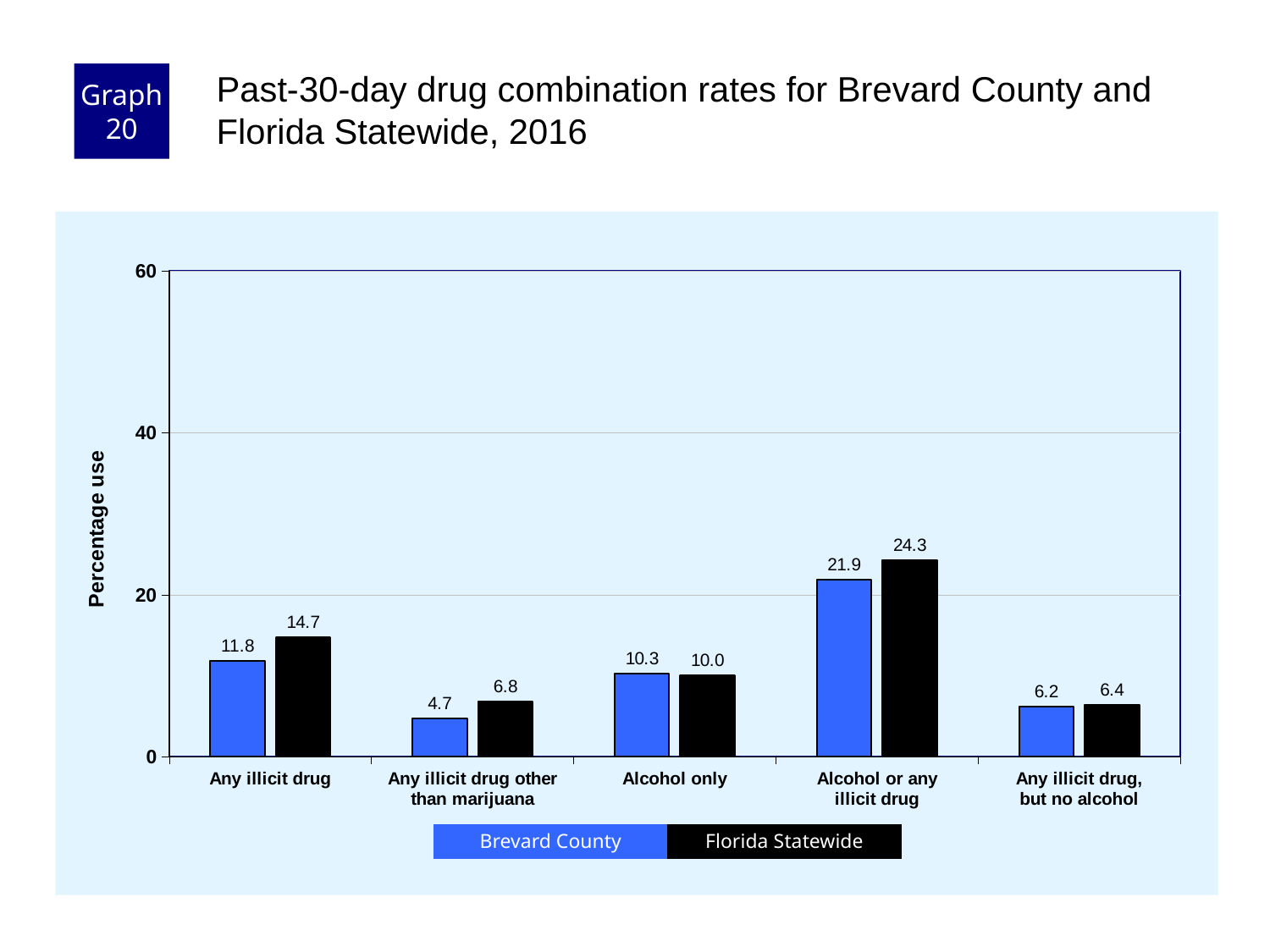
Is the Florida Statewide value for Alcohol or any illicit drug greater or less than 20? greater How many series does the legend list? 2 What is the Brevard County value for Any illicit drug? 11.8 Which is larger for Alcohol only: Brevard County or Florida Statewide? Brevard County What is the Florida Statewide value for Alcohol or any illicit drug? 24.3 Which category has the lowest Florida Statewide value? Any illicit drug, but no alcohol What is the Florida Statewide value for Any illicit drug other than marijuana? 6.8 What is the label of the y axis? Percentage use What kind of chart is shown on the slide? bar chart What is the difference between the Florida Statewide and Brevard County values for Any illicit drug? 2.9 How many categories are shown on the x axis? 5 Which category has the highest Brevard County value? Alcohol or any illicit drug